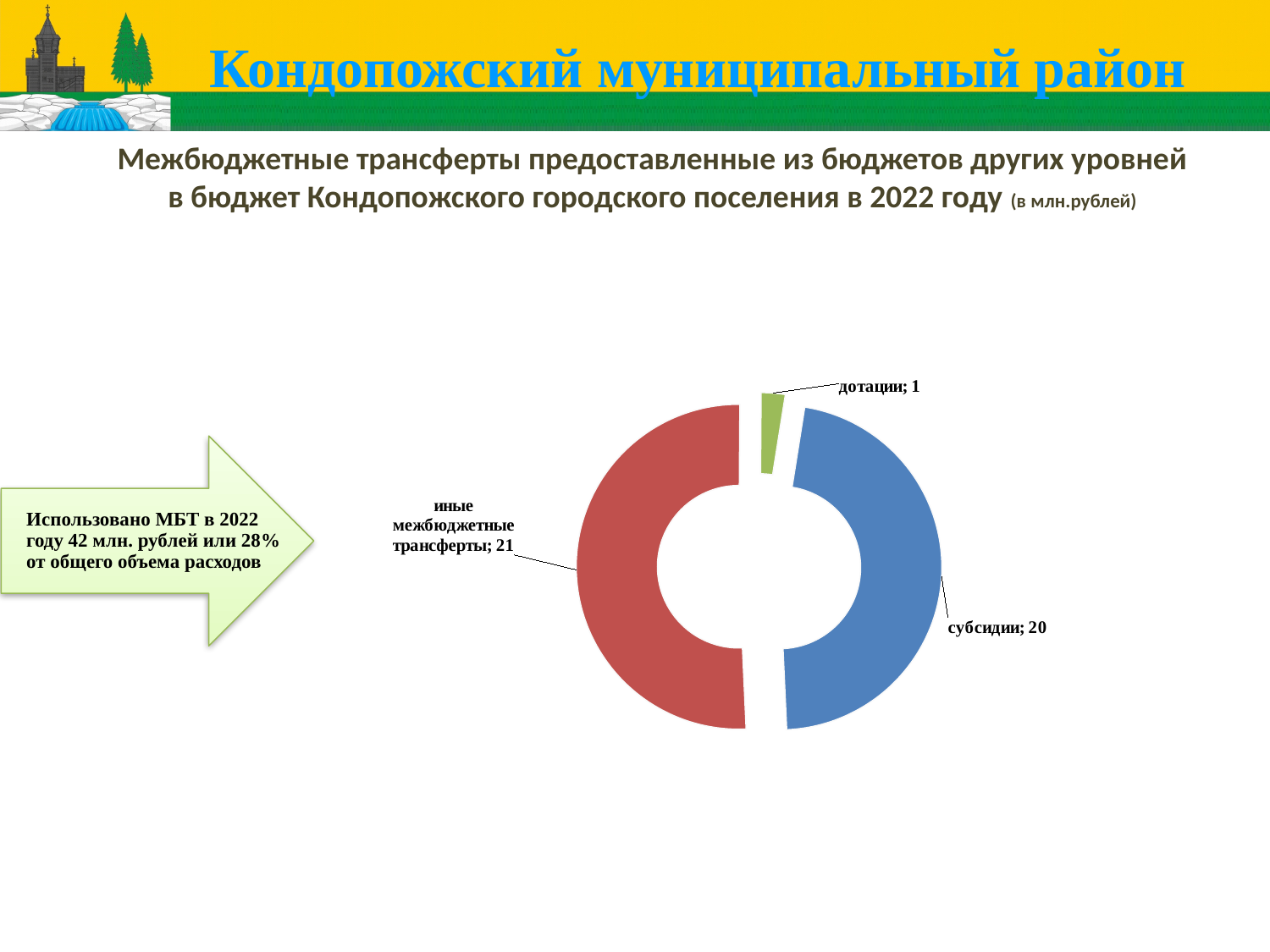
What is the value for иные межбюджетные трансферты on the chart? 21 What is the value for дотации on the chart? 1 Which category has the smallest value on the chart? дотации What is the difference between the values for иные межбюджетные трансферты and субсидии? 1 Which category has the largest value on the chart? иные межбюджетные трансферты What is the total of all the values shown on the chart? 42 What share of the total do иные межбюджетные трансферты represent? 50% What is the value for субсидии on the chart? 20 What kind of chart is shown on the slide? doughnut chart How many categories are shown on the chart? 3 Which is larger, the value for субсидии or the value for дотации? субсидии What is the difference between the values for субсидии and дотации? 19